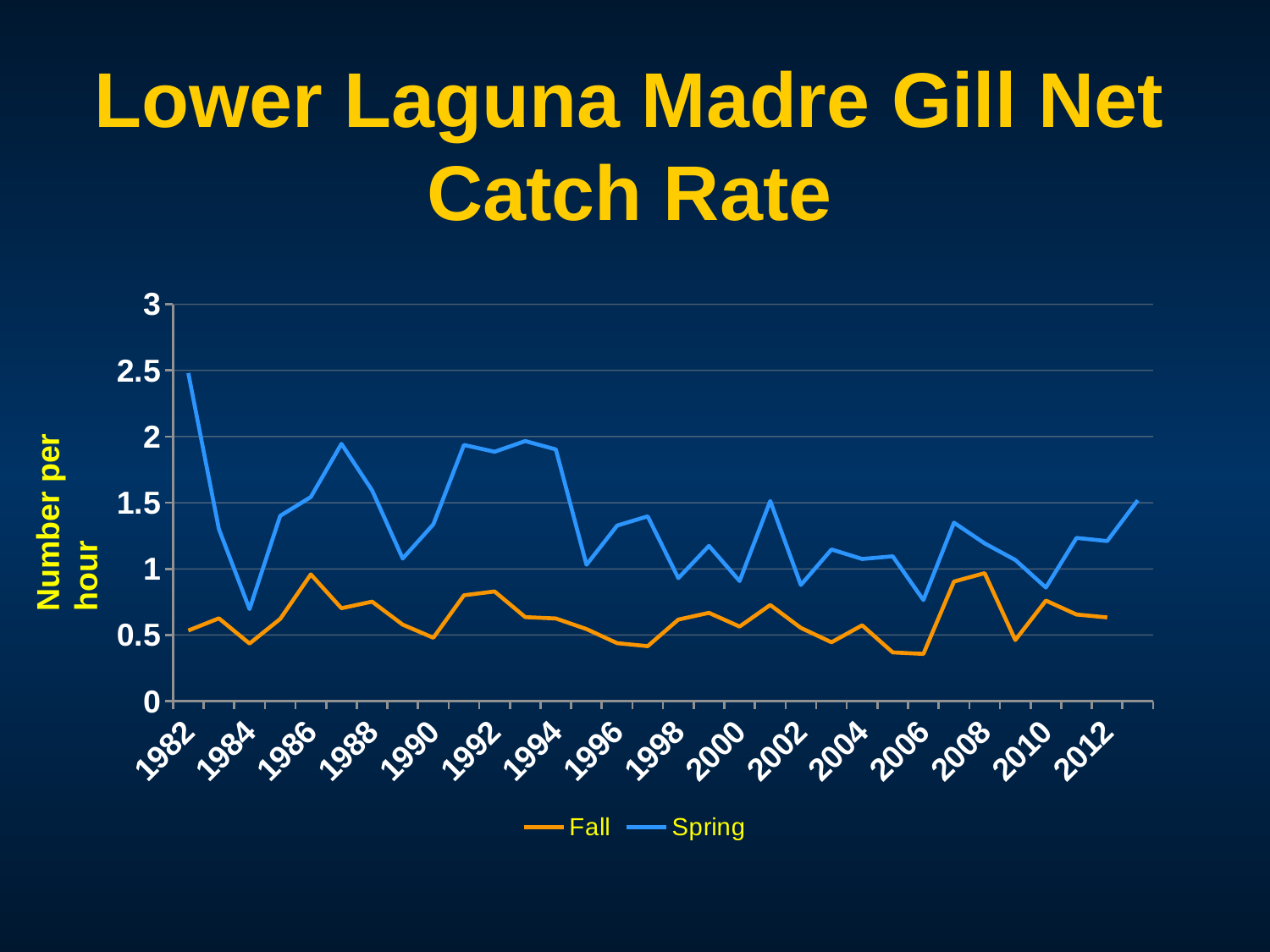
Is the Spring value for 1984 greater or less than 1? less How many series does the legend list? 2 In 1992, which series has the larger value, Fall or Spring? Spring What kind of chart is shown on the slide? line chart What is the label on the vertical axis? Number per hour Is the Spring value for 1982 greater or less than 2? greater Does the Spring series rise or fall between 1982 and 1984? fall What are the two series named in the legend? Fall and Spring Is the Fall value for 2006 greater or less than 0.5? less In which year does the Spring series reach its highest value? 1982